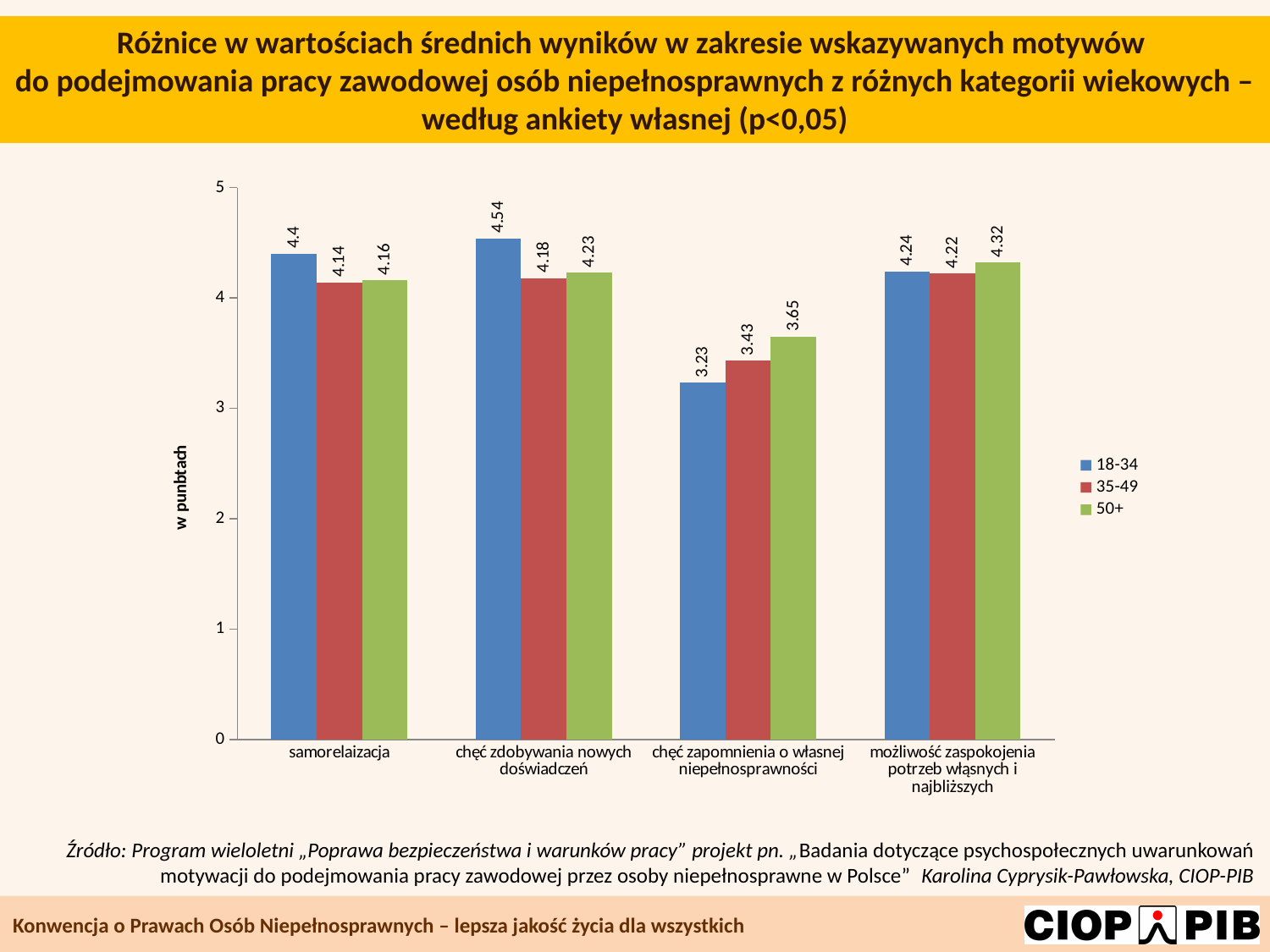
In the 'chęć zapomnienia o własnej niepełnosprawności' category, which series has the larger value, 18-34 or 50+? 50+ What is the value for the 50+ series in the 'chęć zapomnienia o własnej niepełnosprawności' category? 3.65 Which category has the highest value for the 18-34 series? chęć zdobywania nowych doświadczeń How many series does the legend list? 3 What is the difference between the 18-34 and 35-49 values in the 'chęć zdobywania nowych doświadczeń' category? 0.36 Which category has the lowest value for the 50+ series? chęć zapomnienia o własnej niepełnosprawności Is the value for the 18-34 series in 'chęć zapomnienia o własnej niepełnosprawności' greater or less than 4? less What kind of chart is shown on the slide? bar chart What is the label of the vertical axis? w punbtach What is the value for the 18-34 series in the 'samorelaizacja' category? 4.4 What is the value for the 35-49 series in the 'możliwość zaspokojenia potrzeb własnych i najbliższych' category? 4.22 How many categories are shown on the x axis? 4